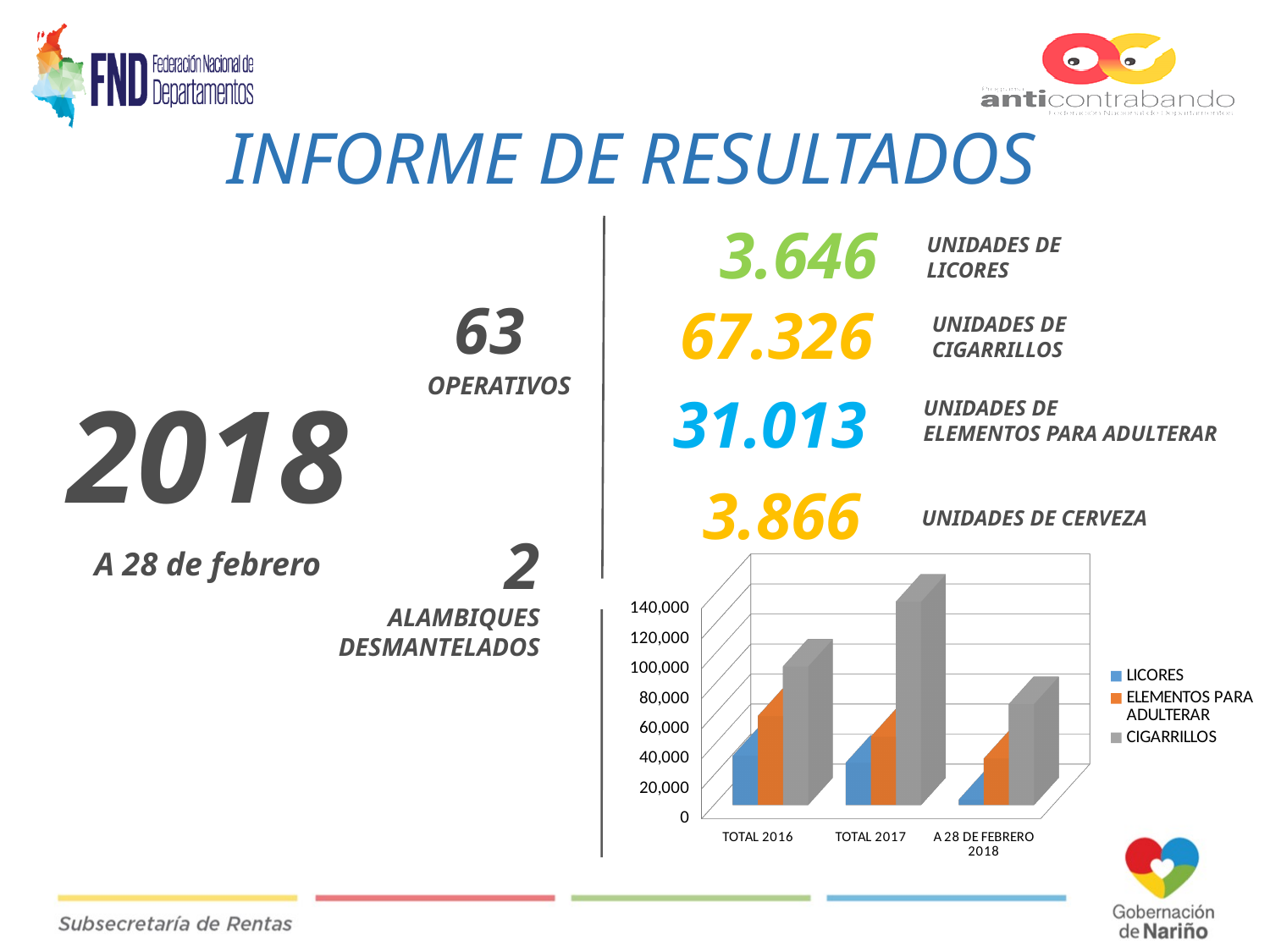
Is the CIGARRILLOS bar larger for TOTAL 2017 or for TOTAL 2016? TOTAL 2017 What colour represents the CIGARRILLOS series in the chart legend? grey Is the value for CIGARRILLOS in TOTAL 2017 greater or less than 100,000? greater Is the value for LICORES in A 28 DE FEBRERO 2018 greater or less than 20,000? less How many series does the chart legend list? 3 Do the LICORES bars rise or fall from TOTAL 2016 to A 28 DE FEBRERO 2018? fall Is the LICORES bar larger for TOTAL 2016 or for A 28 DE FEBRERO 2018? TOTAL 2016 Which series has the lowest bar in the A 28 DE FEBRERO 2018 category? LICORES Which category has the tallest CIGARRILLOS bar? TOTAL 2017 What kind of chart is shown on the slide? bar chart How many categories are shown on the x axis of the chart? 3 Which series has the highest bar in the TOTAL 2016 category? CIGARRILLOS